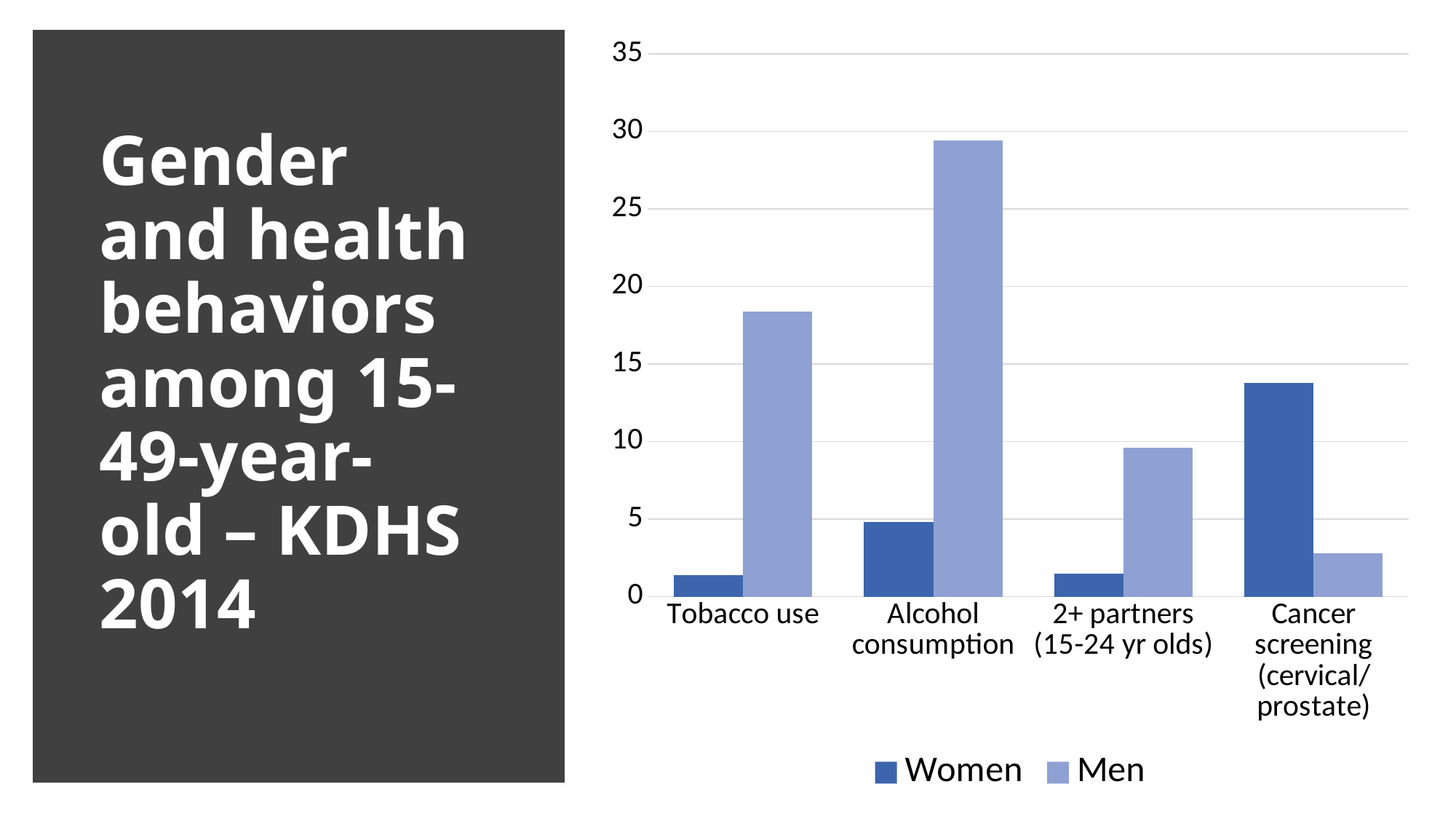
Which category has the lowest value for Men? Cancer screening (cervical/prostate) How many series does the legend list? 2 What kind of chart is shown on the slide? bar chart Is the value for Men in Tobacco use greater or less than 15? greater For Tobacco use, which is larger, the value for Women or for Men? Men For Cancer screening (cervical/prostate), which is larger, the value for Women or for Men? Women Which category has the highest value for Women? Cancer screening (cervical/prostate) Is the value for Women in Cancer screening (cervical/prostate) greater or less than 10? greater Which series is shown in the darker blue colour in the legend? Women Is the value for Men in Alcohol consumption greater or less than 25? greater Which category has the highest value for Men? Alcohol consumption How many categories are shown on the x axis? 4